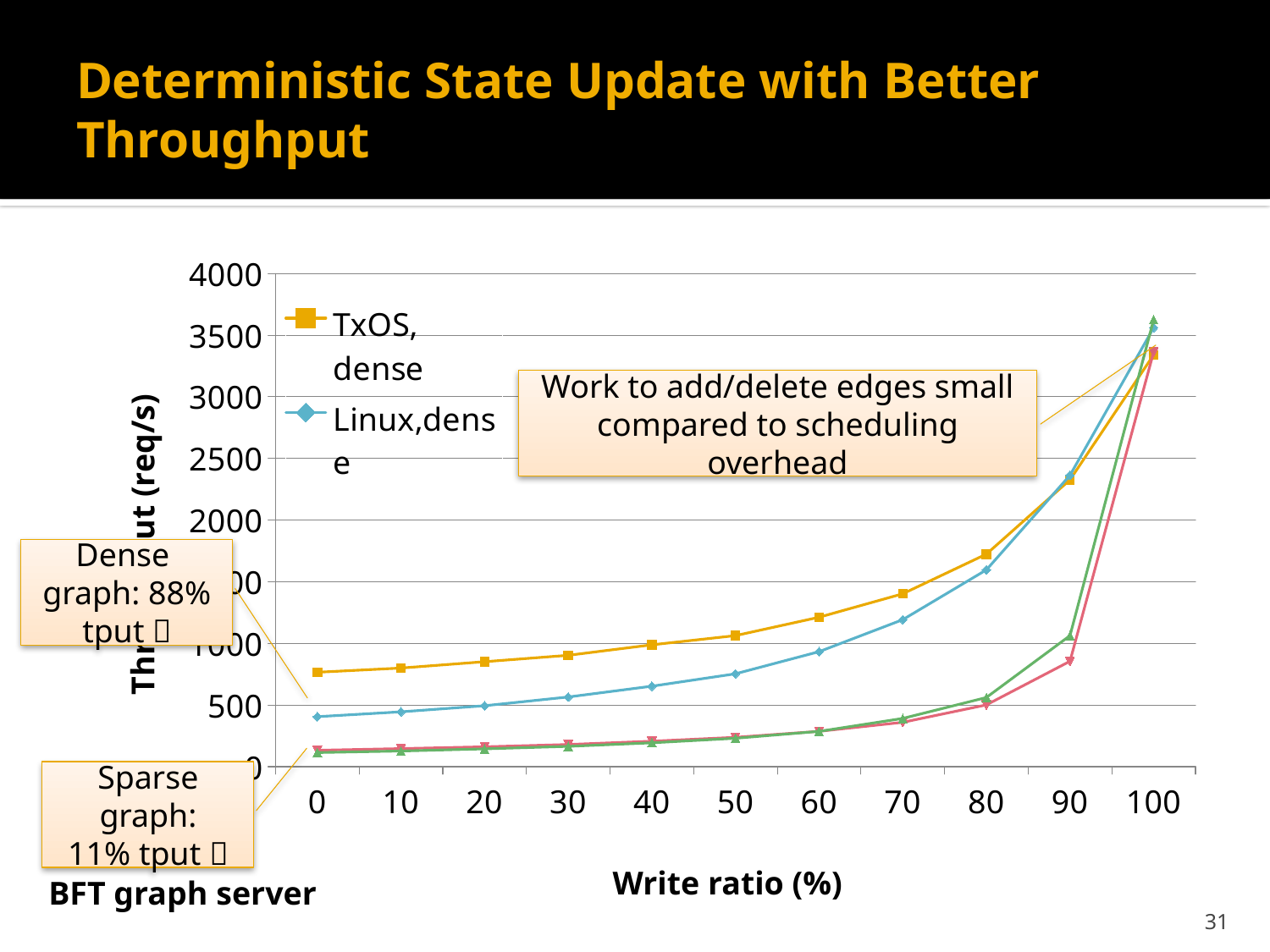
At a write ratio of 100, which series has the higher throughput, TxOS, dense or Linux,dense? Linux,dense Is the throughput for TxOS, dense at a write ratio of 90 greater or less than 2500? less At a write ratio of 0, which series has the higher throughput, TxOS, dense or Linux,dense? TxOS, dense Is the throughput for Linux,dense at a write ratio of 70 greater or less than 1000? greater What kind of chart is shown on the slide? line chart Is the throughput for Linux,dense at a write ratio of 0 greater or less than 500? less Does the throughput for TxOS, dense rise or fall as the write ratio increases from 0 to 100? rise What is the title of the x axis? Write ratio (%) How many write-ratio points are plotted along the x axis? 11 What is the highest value shown on the y axis? 4000